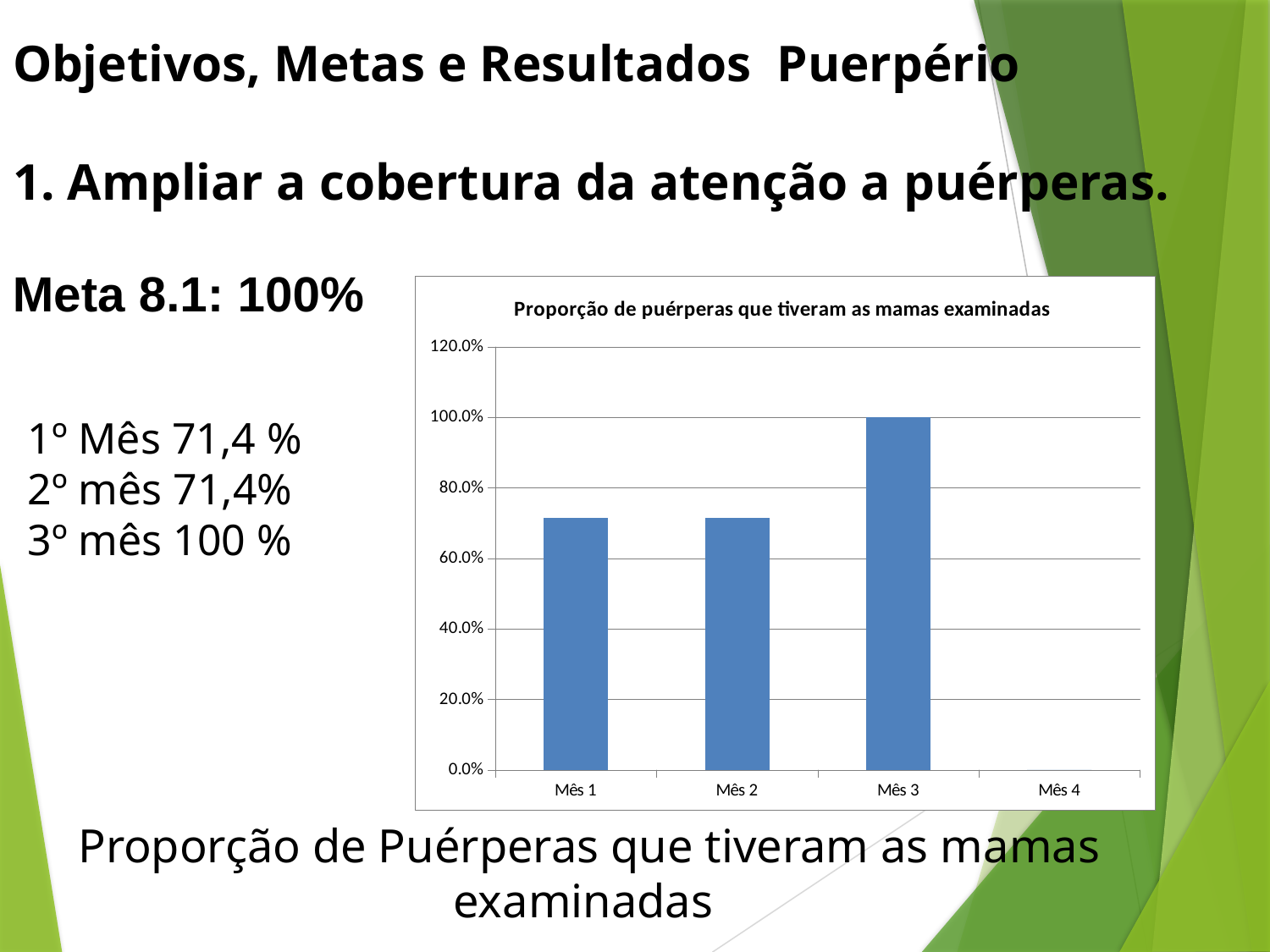
What is the value for Mês 3 in the chart? 100.0% How many categories are shown on the x axis of the chart? 4 Is the value for Mês 3 greater or less than 80.0%? greater What is the title of the chart? Proporção de puérperas que tiveram as mamas examinadas Which month has the lowest value in the chart? Mês 4 Is the value for Mês 1 greater or less than 60.0%? greater Which month has the highest value in the chart? Mês 3 What kind of chart is shown on the slide? bar chart Is the value for Mês 2 greater or less than 80.0%? less Which is larger, the value for Mês 1 or the value for Mês 3? Mês 3 What colour are the bars in the chart? blue Does the value rise or fall from Mês 2 to Mês 3? rise